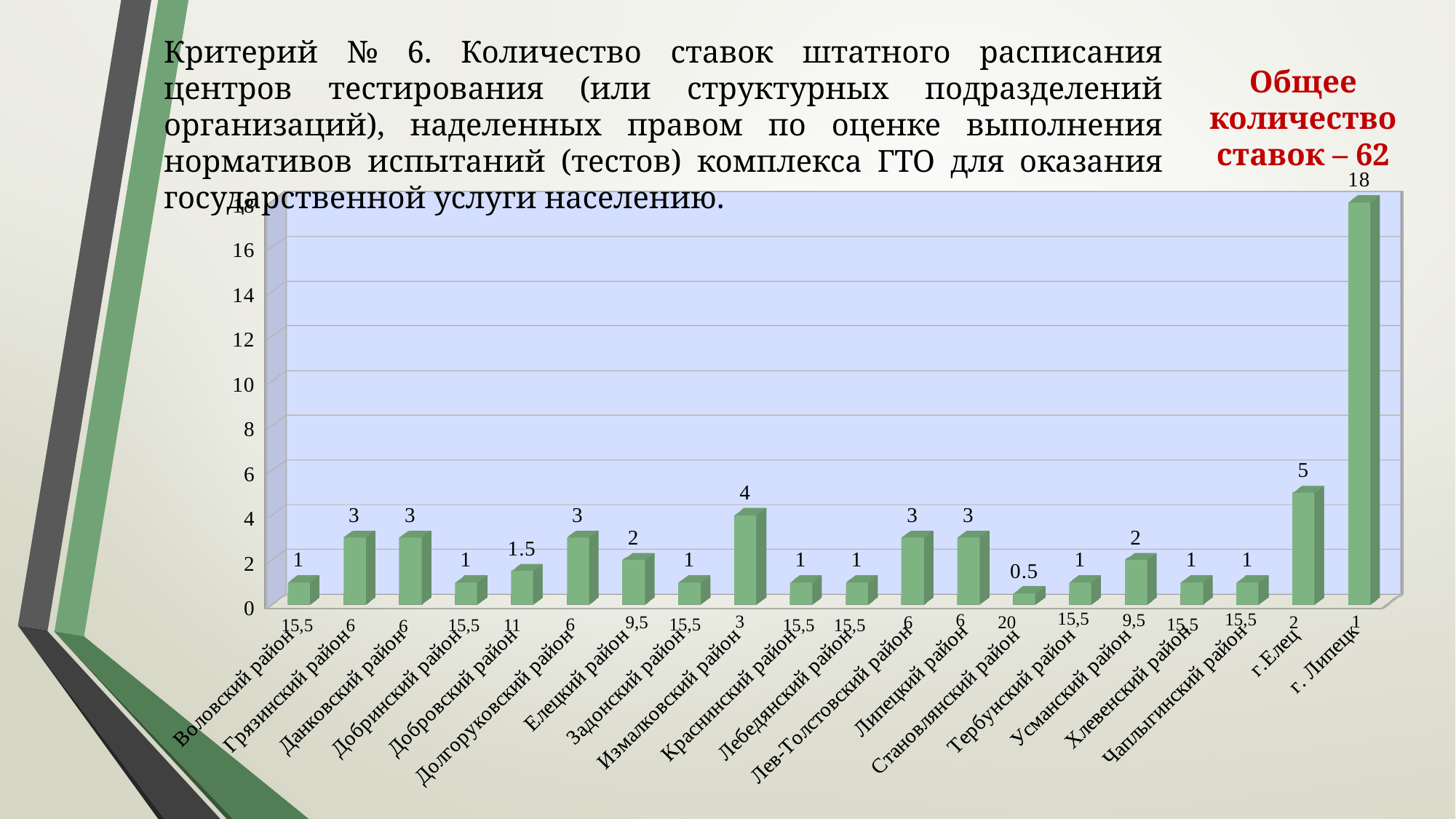
Which category has the highest value on the chart? г. Липецк How many categories (districts and cities) are plotted on the chart? 20 What is the value for г.Елец? 5 What type of chart is shown on the slide? bar chart What is the difference between the values for г. Липецк and г.Елец? 13 Which is larger, the value for Елецкий район or the value for Измалковский район? Измалковский район What is the value for Измалковский район? 4 What is the value for г. Липецк? 18 Which category has the lowest value on the chart? Становлянский район What is the value for Добровский район? 1.5 What is the value for Становлянский район? 0.5 What total number of ставок is stated in red text on the slide? 62